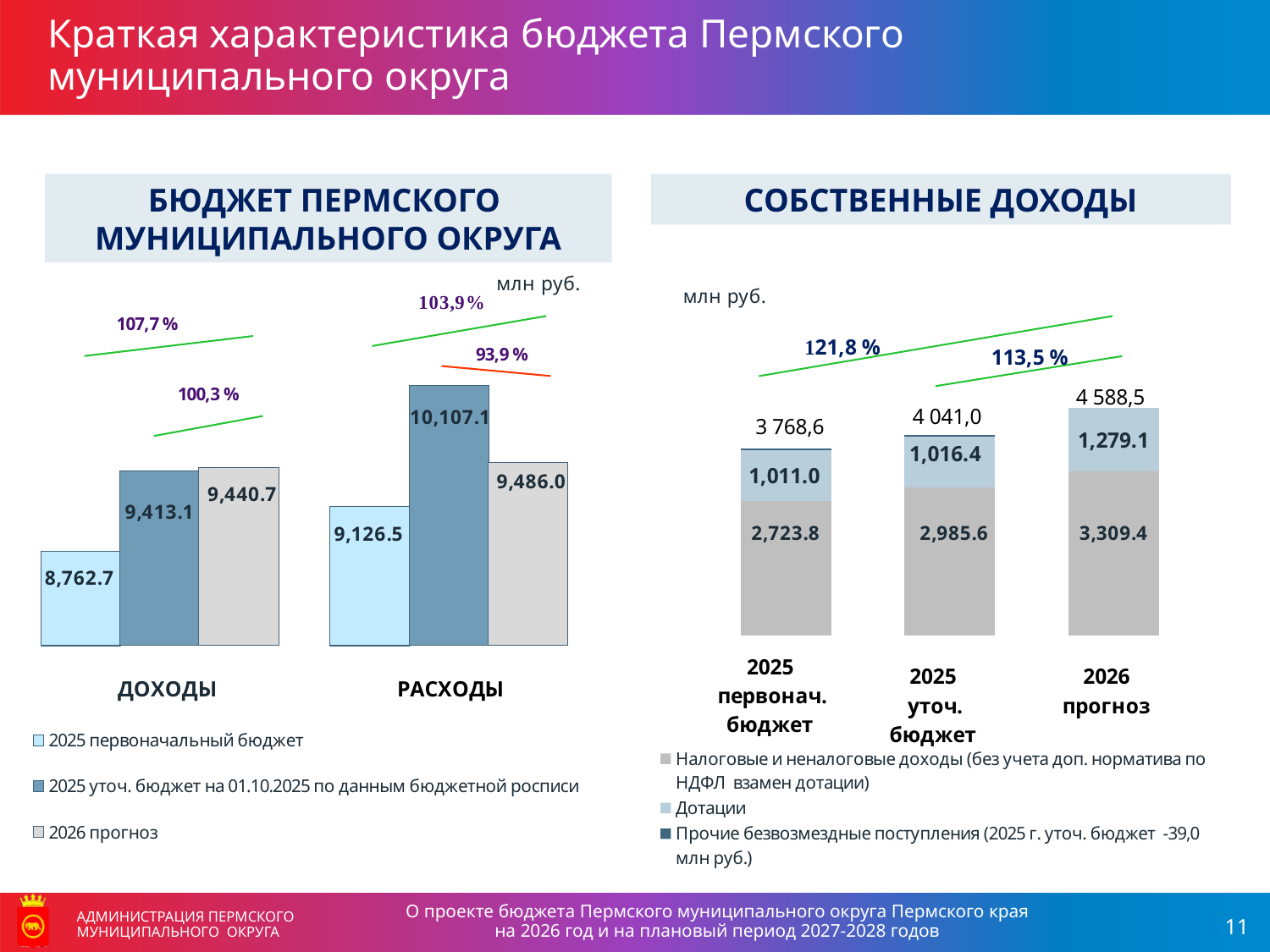
On the chart titled 'СОБСТВЕННЫЕ ДОХОДЫ', what is the total of the stacked bar for 2025 первонач. бюджет? 3 768,6 On the chart titled 'СОБСТВЕННЫЕ ДОХОДЫ', what is the value of Налоговые и неналоговые доходы for 2026 прогноз? 3,309.4 On the chart titled 'СОБСТВЕННЫЕ ДОХОДЫ', how many categories are shown on the x axis? 3 On the chart titled 'БЮДЖЕТ ПЕРМСКОГО МУНИЦИПАЛЬНОГО ОКРУГА', what is the 2026 прогноз value for ДОХОДЫ? 9,440.7 On the chart titled 'БЮДЖЕТ ПЕРМСКОГО МУНИЦИПАЛЬНОГО ОКРУГА', which bar is the highest? РАСХОДЫ, 2025 уточ. бюджет (10,107.1) On the chart titled 'БЮДЖЕТ ПЕРМСКОГО МУНИЦИПАЛЬНОГО ОКРУГА', what is the value of ДОХОДЫ for the 2025 первоначальный бюджет series? 8,762.7 On the chart titled 'СОБСТВЕННЫЕ ДОХОДЫ', what is the value of Дотации for 2025 уточ. бюджет? 1,016.4 What kind of chart is the chart titled 'БЮДЖЕТ ПЕРМСКОГО МУНИЦИПАЛЬНОГО ОКРУГА'? Bar chart On the chart titled 'БЮДЖЕТ ПЕРМСКОГО МУНИЦИПАЛЬНОГО ОКРУГА', what is the value of РАСХОДЫ for the 2025 уточ. бюджет series? 10,107.1 On the chart titled 'БЮДЖЕТ ПЕРМСКОГО МУНИЦИПАЛЬНОГО ОКРУГА', how many series does the legend list? 3 On the chart titled 'СОБСТВЕННЫЕ ДОХОДЫ', do the bar totals rise or fall from left to right? Rise On the chart titled 'БЮДЖЕТ ПЕРМСКОГО МУНИЦИПАЛЬНОГО ОКРУГА', what is the difference between РАСХОДЫ and ДОХОДЫ in the 2026 прогноз series? 45.3